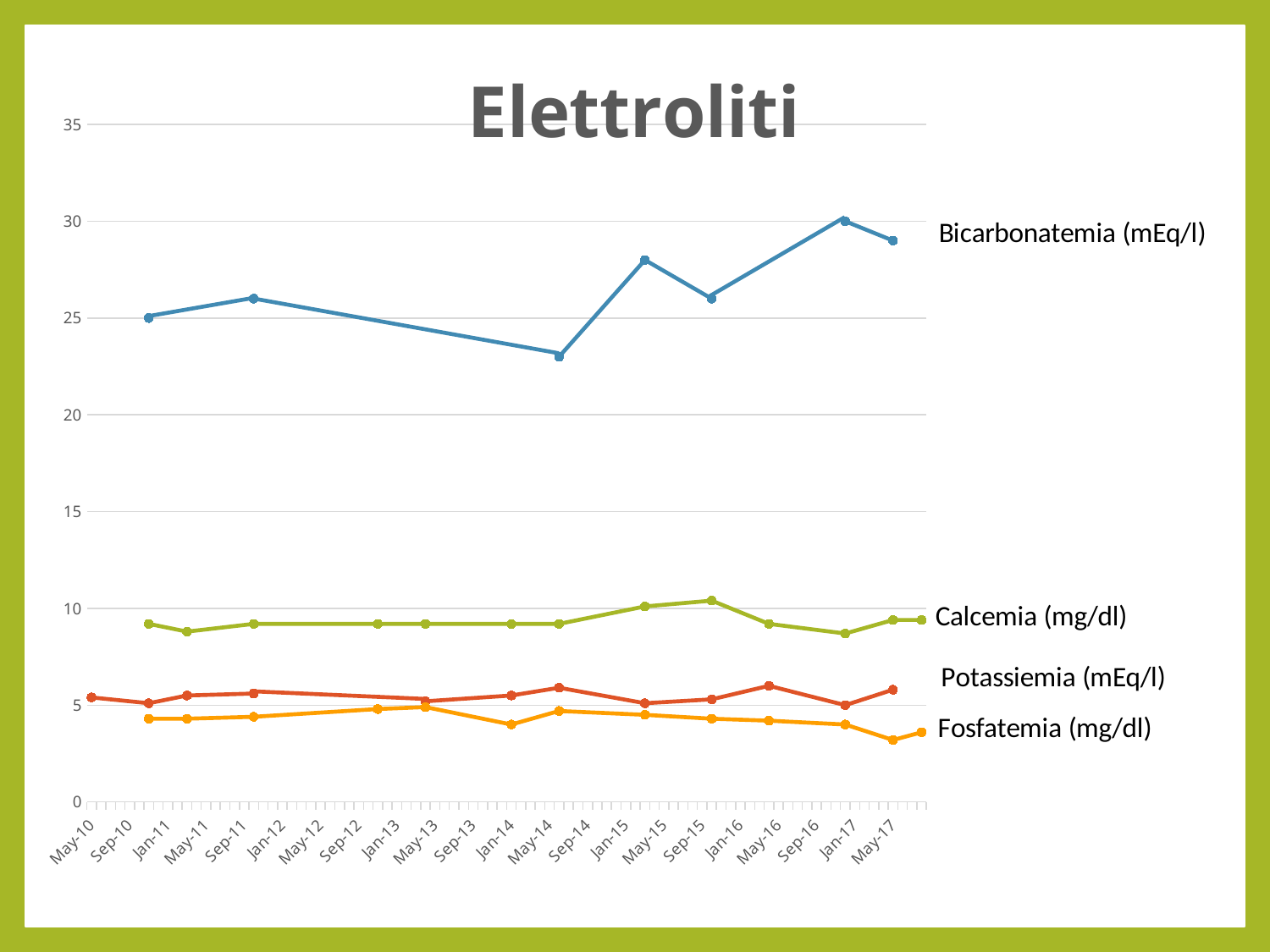
What kind of chart is shown on the slide? line chart Which series is higher, Bicarbonatemia (mEq/l) or Calcemia (mg/dl)? Bicarbonatemia (mEq/l) Does the Bicarbonatemia (mEq/l) line end higher or lower than it starts? higher Which series has the highest values on the chart? Bicarbonatemia (mEq/l) Which series is plotted with the blue line? Bicarbonatemia (mEq/l) Which series is higher, Potassiemia (mEq/l) or Fosfatemia (mg/dl)? Potassiemia (mEq/l) Is the highest value for Calcemia (mg/dl) greater or less than 15? less Is the highest value for Bicarbonatemia (mEq/l) greater or less than 25? greater Is the lowest value for Bicarbonatemia (mEq/l) greater or less than 25? less What is the title of the chart? Elettroliti How many series are plotted on the chart? 4 Which series has the lowest values on the chart? Fosfatemia (mg/dl)